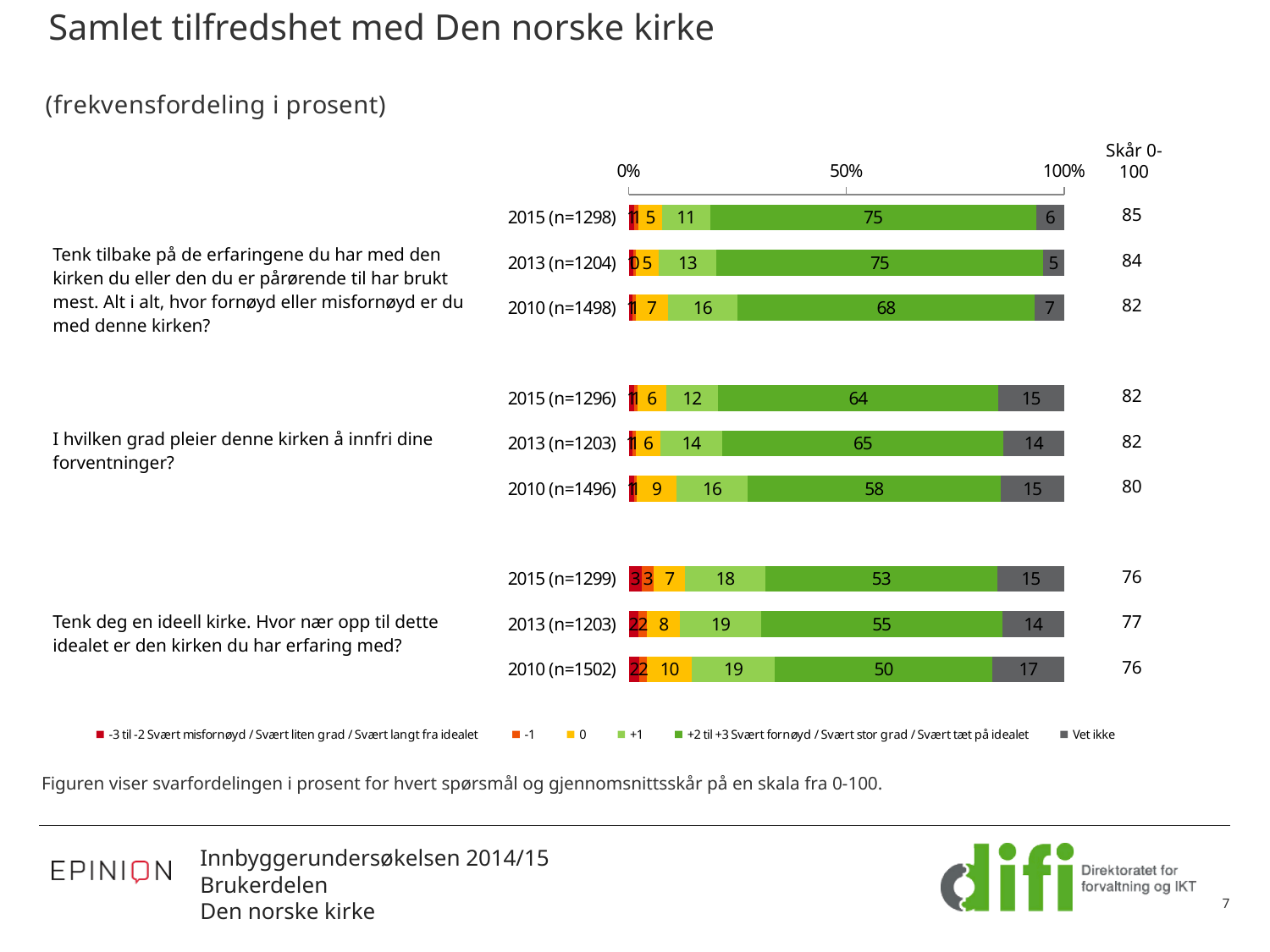
What is the difference in the "+2 til +3" share between 2015 (n=1298) and 2010 (n=1498) on the first question? 7 Which bar has the lowest "+2 til +3" share? 2010 (n=1502) What percentage of respondents in 2015 (n=1298) answered "+2 til +3" for the question about overall satisfaction with the church? 75 What kind of chart is shown on the slide? Stacked bar chart How many stacked bars are shown in the chart? 9 Which has a larger "+1" share: 2010 (n=1498) or 2015 (n=1298)? 2010 (n=1498) How many series does the legend list? 6 What is the "Skår 0-100" value for 2015 (n=1298) on the first question? 85 What percentage of respondents in 2013 (n=1203) answered "+1" on the question about the ideal church? 19 Does the "Skår 0-100" value for the first question rise or fall from 2010 to 2015? Rise What percentage of respondents in 2010 (n=1502) answered "Vet ikke" on the question about the ideal church? 17 Which bar has the highest "Vet ikke" share? 2010 (n=1502)